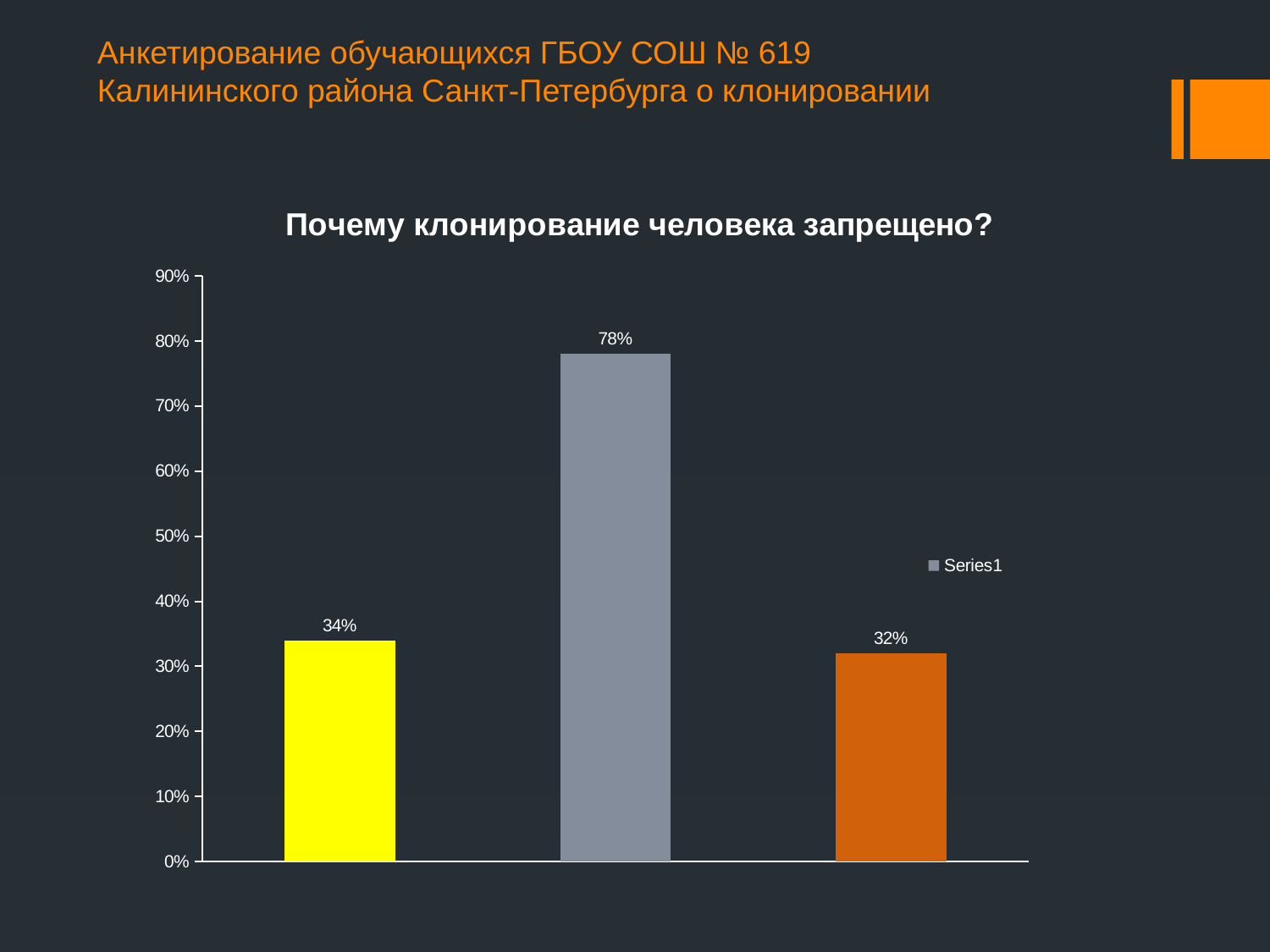
What type of chart is shown on the slide? bar chart How many bars are plotted in the chart? 3 What is the value shown on the middle (grey) bar? 78% Which bar has the highest value? the middle (grey) bar Is the value of the middle bar greater or less than 70%? greater What is the name of the series shown in the legend? Series1 What is the value shown on the leftmost (yellow) bar? 34% What is the value shown on the rightmost (orange) bar? 32% What is the difference between the leftmost bar's value and the rightmost bar's value? 2% What is the title of the chart? Почему клонирование человека запрещено? How many series does the legend list? 1 What is the difference between the middle bar's value and the rightmost bar's value? 46%